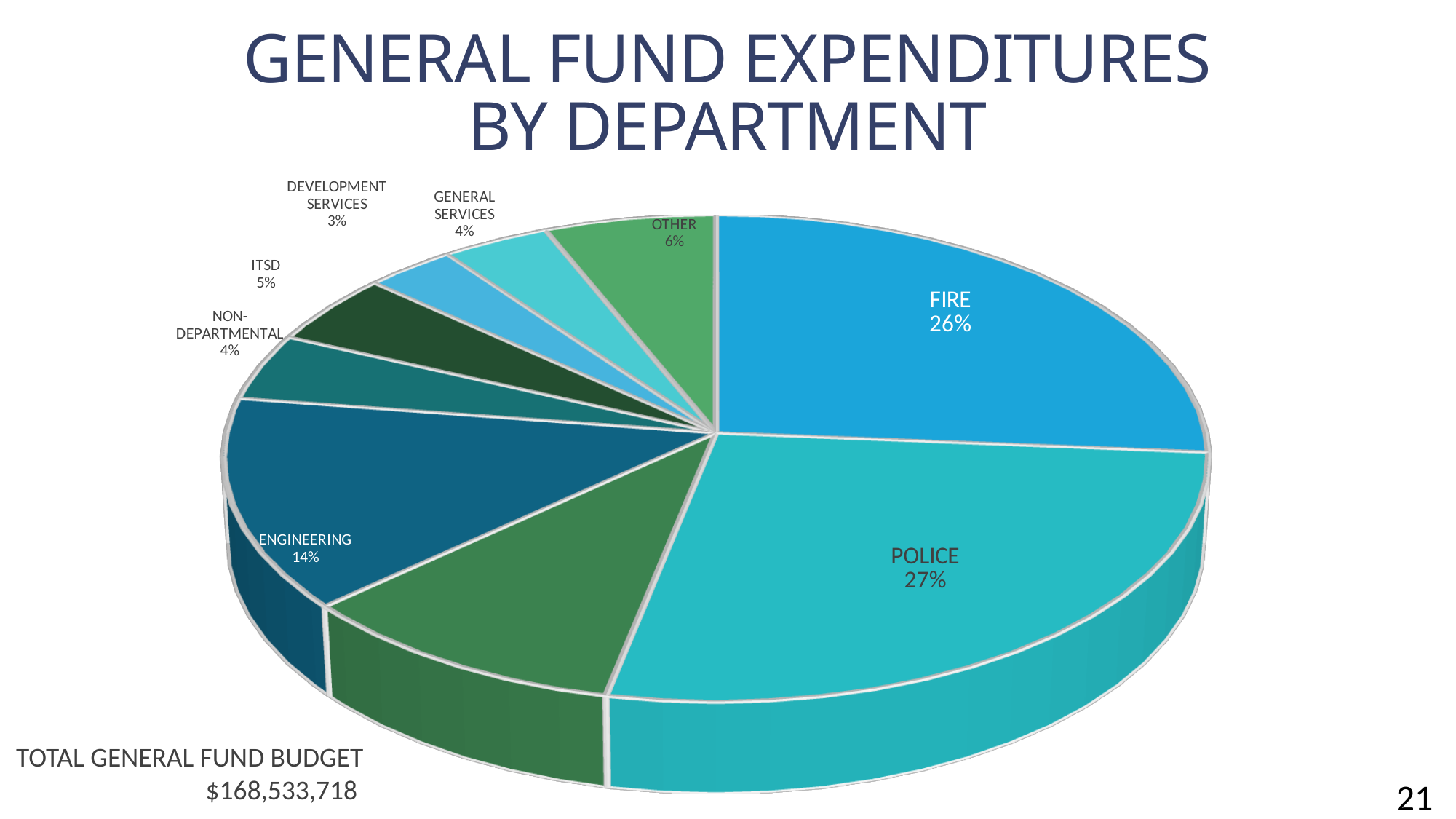
Which labeled department has the smallest share of expenditures? Development Services Which labeled department has the largest share of expenditures? Police What percentage is shown for Other? 6% What kind of chart is shown on the slide? Pie chart What percentage is shown for Development Services? 3% What percentage is shown for ITSD? 5% What is the total general fund budget stated on the slide? $168,533,718 What percentage is shown for Engineering? 14% What is the difference in percentage points between Police and Fire? 1% Which has a larger share, Fire or Engineering? Fire What percentage of general fund expenditures goes to Fire? 26% What share of the pie is Police? 27%